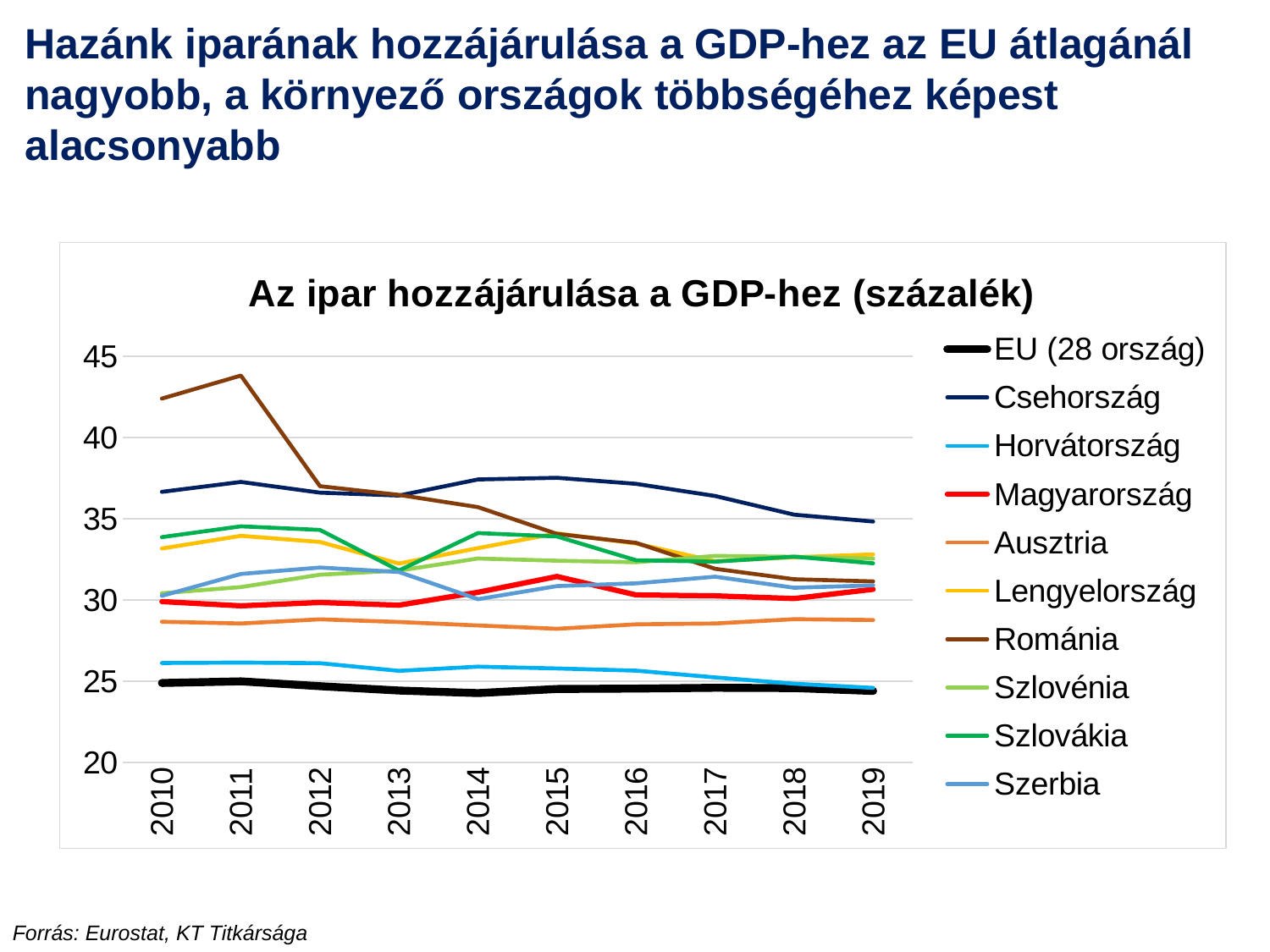
Does the value for Csehország rise or fall from 2015 to 2019? fall What is the title of the chart? Az ipar hozzájárulása a GDP-hez (százalék) Is the value for EU (28 ország) in 2019 greater or less than 25? less Does the value for Románia rise or fall from 2010 to 2019? fall Is the value for Ausztria in 2015 greater or less than 30? less Which is larger in 2019, the value for Csehország or the value for Magyarország? Csehország What kind of chart is shown on the slide? line chart How many series does the legend list? 10 Which series has the highest value in 2010? Románia Which series has the lowest value in 2010? EU (28 ország) How many years are shown on the x axis? 10 Is the value for Románia in 2011 greater or less than 40? greater